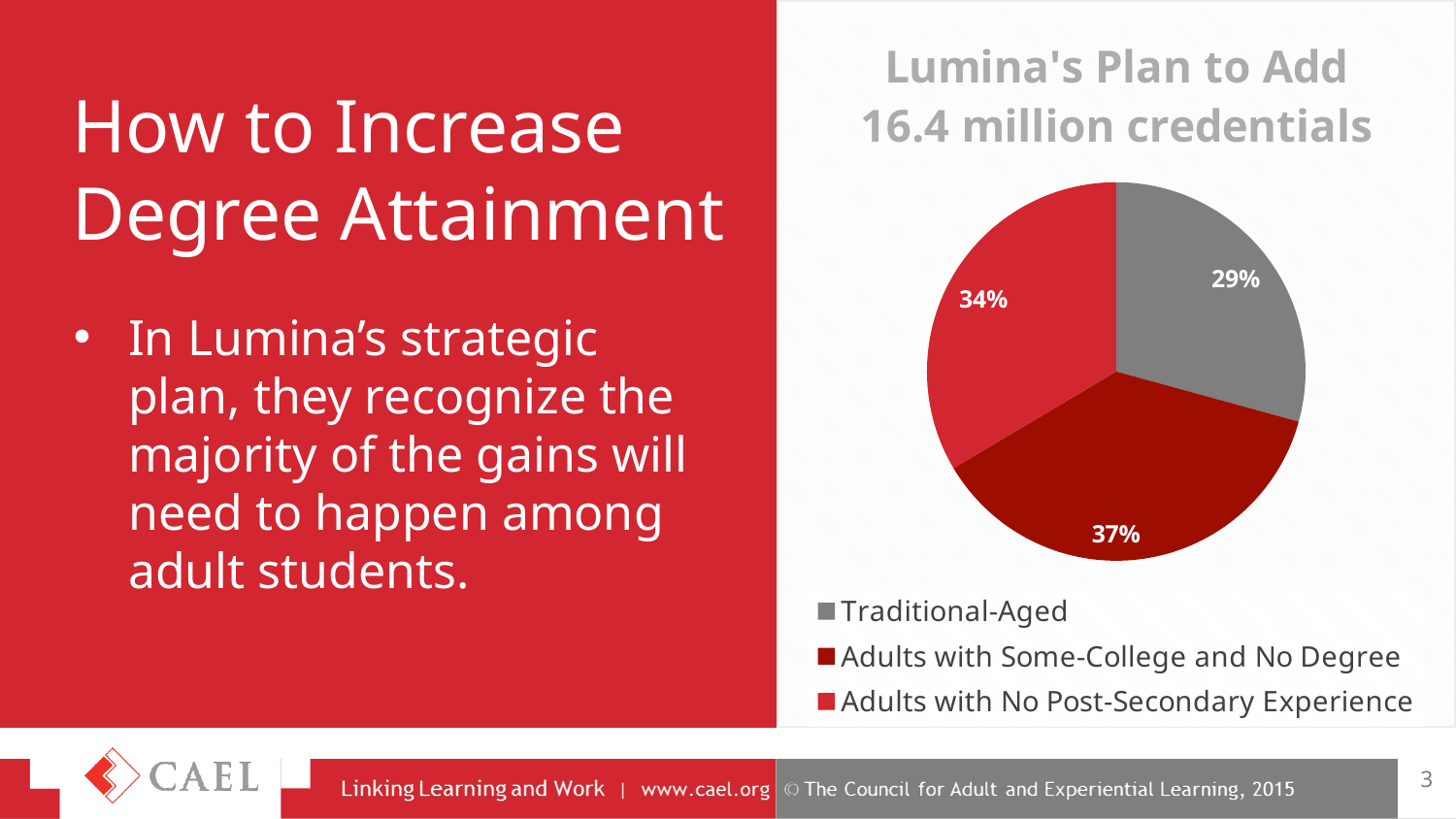
What is the title of the chart? Lumina's Plan to Add 16.4 million credentials What is the difference in percentage points between Adults with Some-College and No Degree and Traditional-Aged? 8 Which category has the smallest slice of the pie? Traditional-Aged What share of the pie is Adults with No Post-Secondary Experience? 34% What kind of chart is shown on the slide? pie chart How many entries does the legend list? 3 How many slices does the pie chart have? 3 Which is larger: the share for Adults with No Post-Secondary Experience or the share for Traditional-Aged? Adults with No Post-Secondary Experience Which category has the largest slice of the pie? Adults with Some-College and No Degree Which colour represents Traditional-Aged in the pie chart? gray What share of the pie is Traditional-Aged? 29% What share of the pie is Adults with Some-College and No Degree? 37%